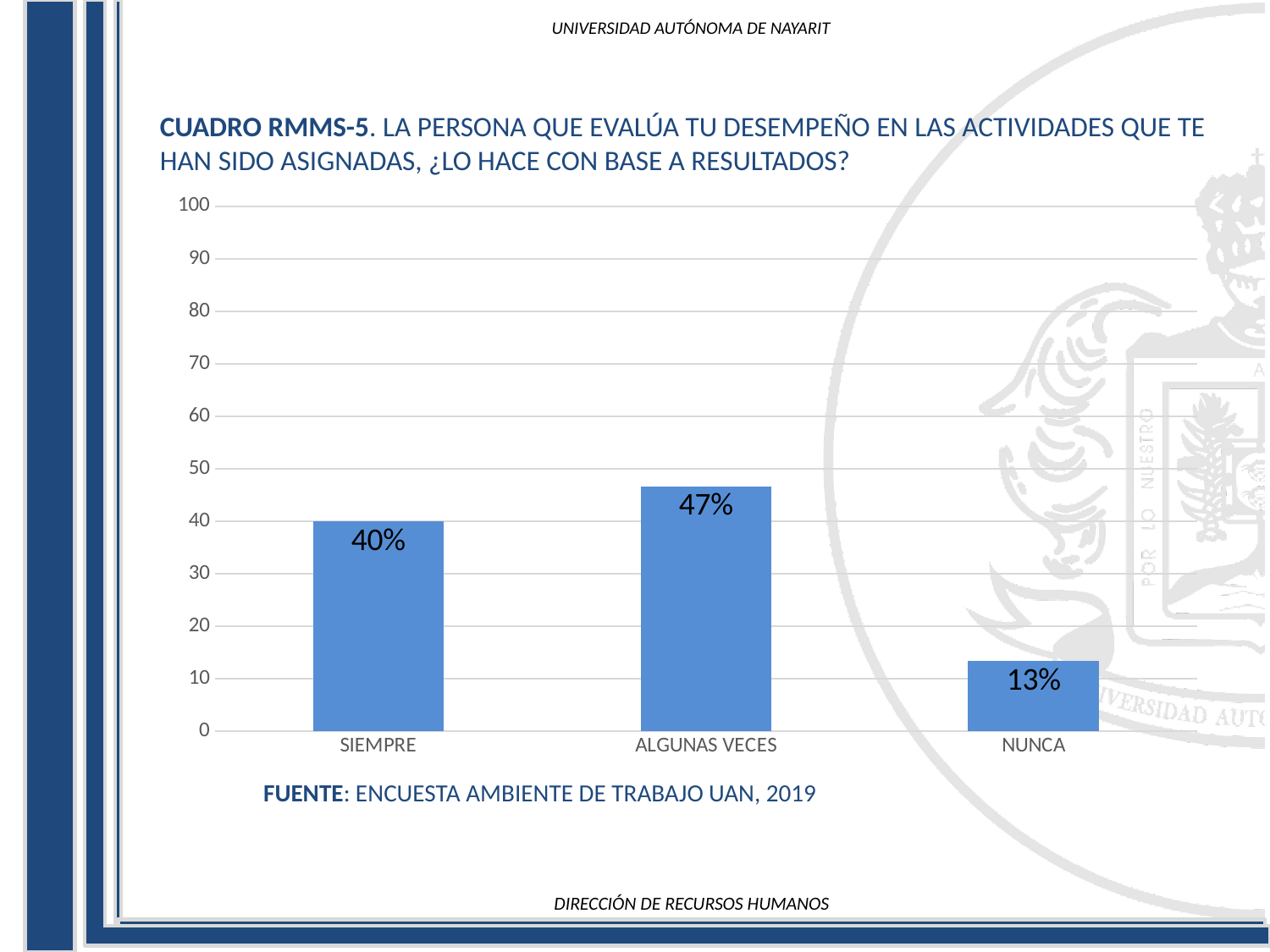
What kind of chart is shown on the slide? bar chart What is the value for ALGUNAS VECES? 47% Is the value for ALGUNAS VECES greater or less than 50? less How many categories are shown on the x axis? 3 What is the difference between the values for SIEMPRE and NUNCA? 27% Which category has the highest value? ALGUNAS VECES What is the value for NUNCA? 13% Which is larger, the value for SIEMPRE or the value for NUNCA? SIEMPRE What is the difference between the values for ALGUNAS VECES and SIEMPRE? 7% What is the value for SIEMPRE? 40% Which category has the lowest value? NUNCA What source is cited below the chart? ENCUESTA AMBIENTE DE TRABAJO UAN, 2019